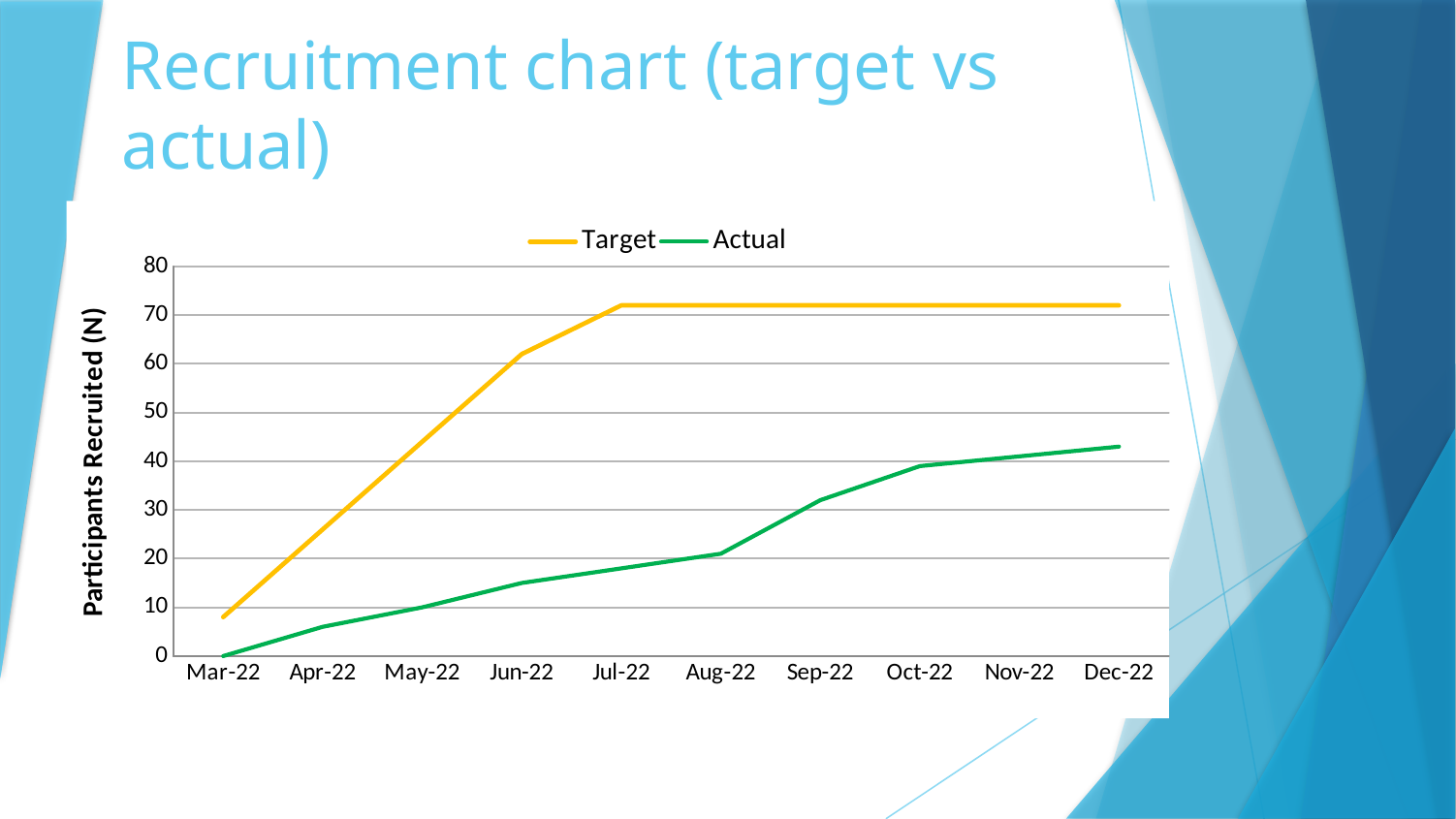
Which colour is used for the Target line? yellow How many months are shown along the x axis? 10 What kind of chart is shown on the slide? line chart Is the Actual value for Dec-22 greater or less than 40? greater Does the Actual line rise or fall from Mar-22 to Dec-22? rise Is the Target value for Jul-22 greater or less than 70? greater What is the label on the y axis? Participants Recruited (N) How many series does the legend list? 2 Which is larger in Jun-22, the Target value or the Actual value? Target Is the Actual value for Aug-22 greater or less than 30? less What is the Actual value for Mar-22? 0 In which month is the Actual value lowest? Mar-22